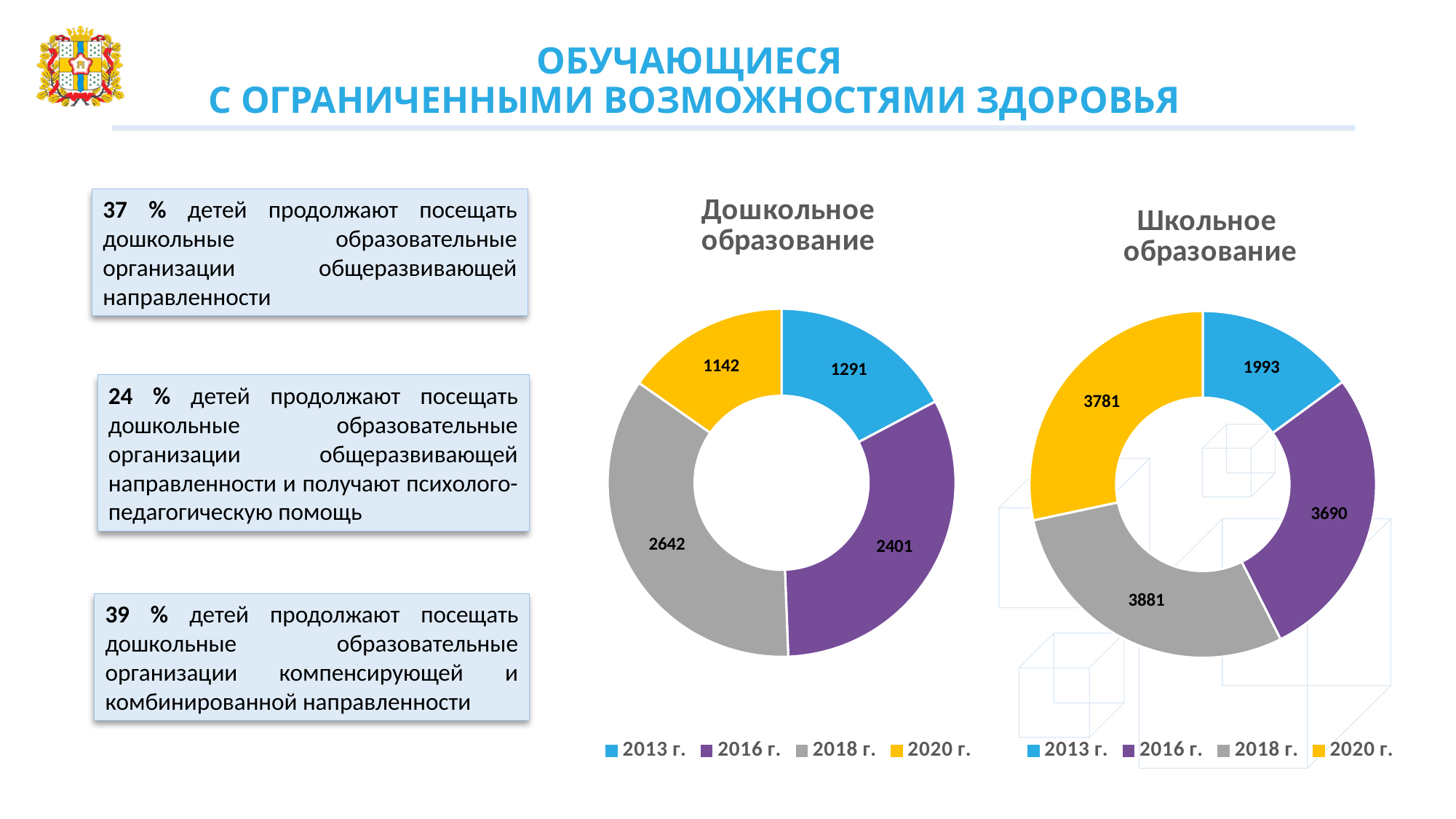
In the Дошкольное образование chart, which year has the largest value? 2018 г. In the Школьное образование chart, what is the difference between the values for 2018 г. and 2013 г.? 1888 In the Школьное образование chart, what is the value for 2016 г.? 3690 In the Школьное образование chart, which year has the smallest value? 2013 г. In the Дошкольное образование chart, which year has the smallest value? 2020 г. What type of chart is the Дошкольное образование chart? Doughnut chart How many entries does the legend of the Школьное образование chart list? 4 In the Дошкольное образование chart, what is the difference between the values for 2018 г. and 2020 г.? 1500 In the Дошкольное образование chart, what is the value for 2018 г.? 2642 In the Дошкольное образование chart, what is the value for 2013 г.? 1291 In the Школьное образование chart, what is the value for 2020 г.? 3781 In the Школьное образование chart, which is larger: the value for 2016 г. or the value for 2013 г.? 2016 г.